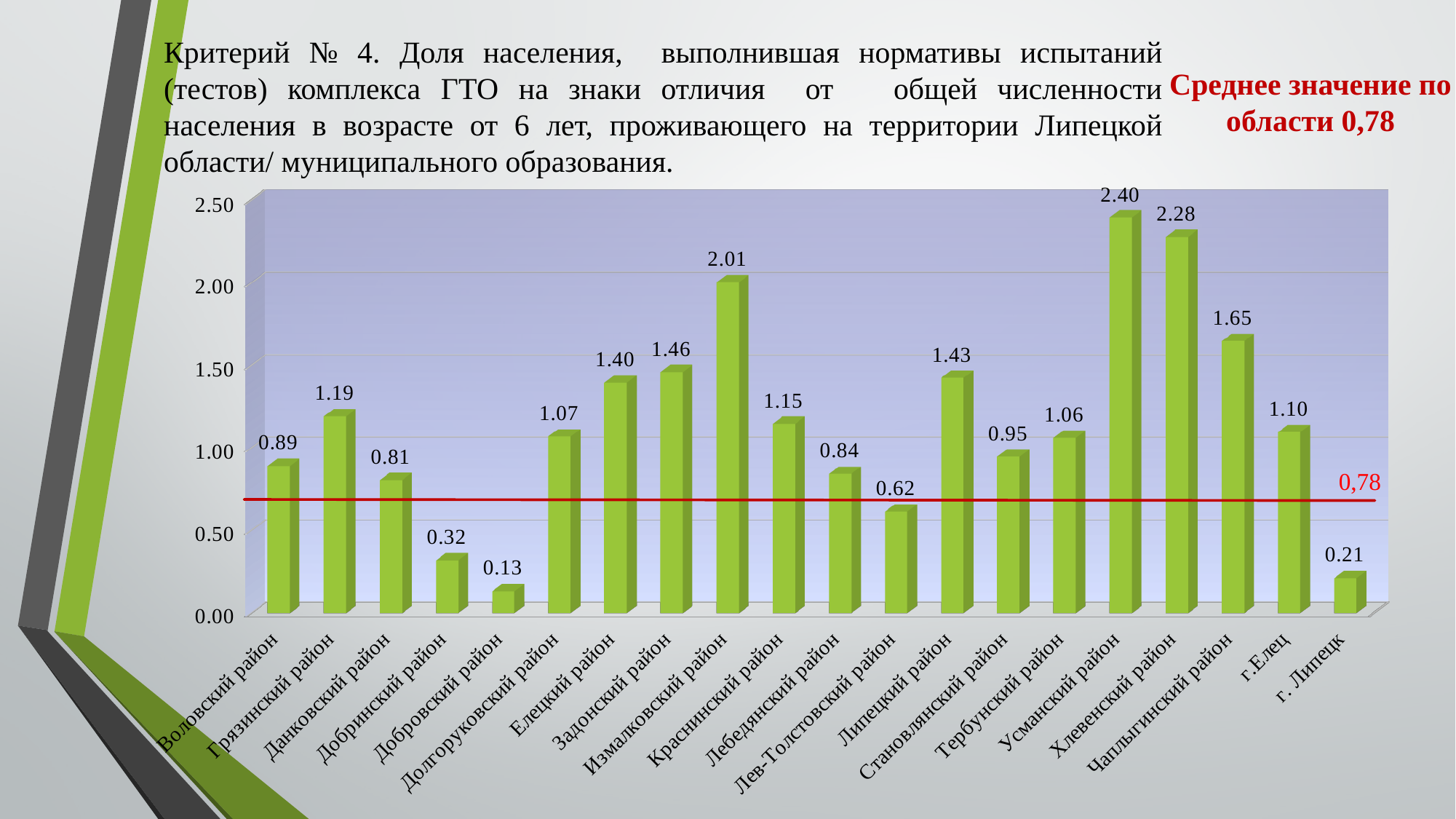
What kind of chart is shown on the slide? bar chart What value does the red horizontal line on the chart mark? 0,78 What is the value for г. Липецк? 0.21 Is the value for Лев-Толстовский район greater or less than 1.00? less How many categories are shown on the x axis? 20 Which category has the highest value? Усманский район What is the difference between the values for Усманский район and Хлевенский район? 0.12 Which is larger, the value for Грязинский район or the value for Краснинский район? Грязинский район Which category has the lowest value? Добровский район What is the value for Измалковский район? 2.01 What is the value for Чаплыгинский район? 1.65 What is the difference between the value for Добринский район and the value for Добровский район? 0.19